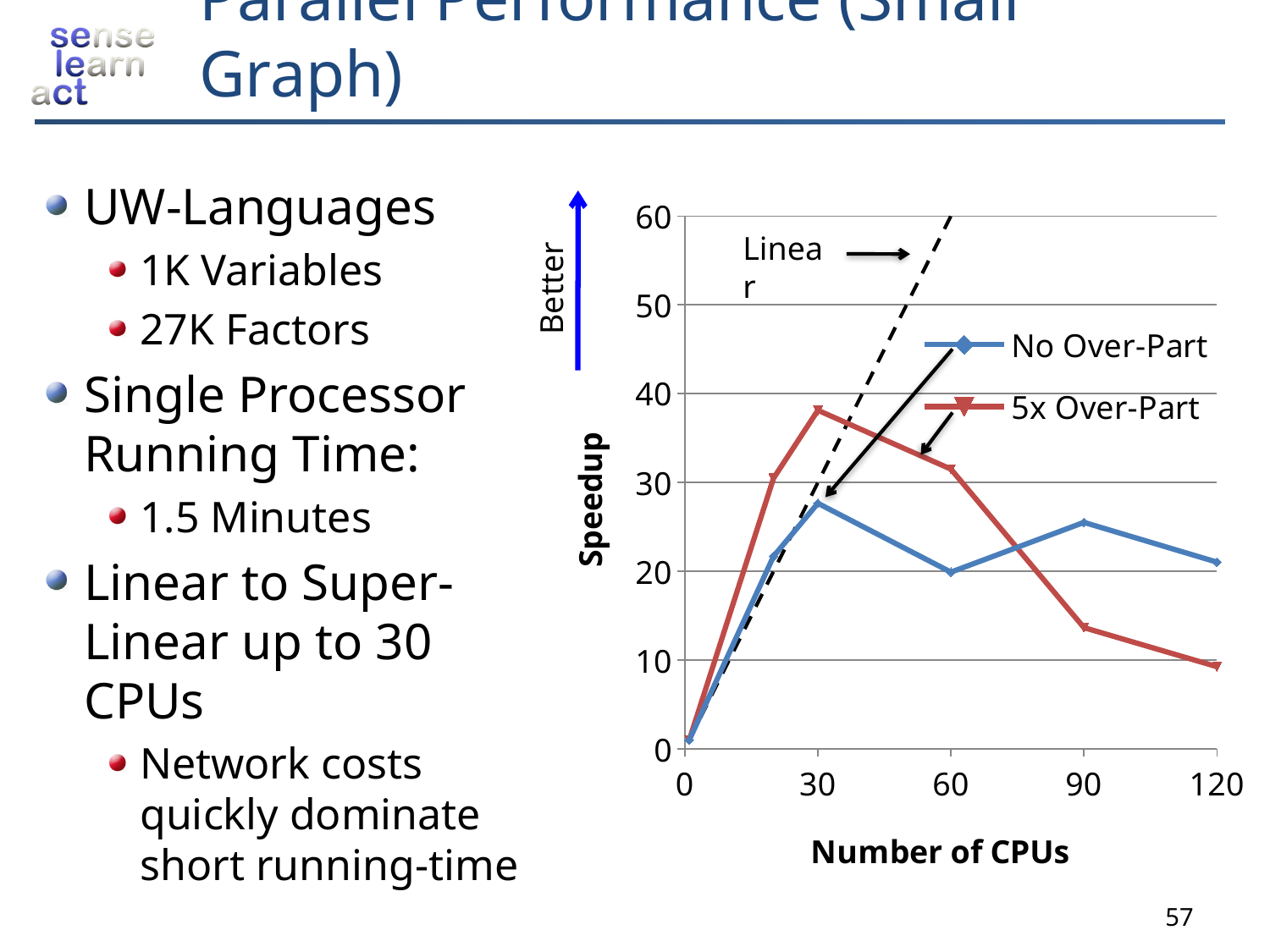
What kind of chart is shown on the slide? line chart What is the title of the chart's x axis? Number of CPUs Is the speedup for 5x Over-Part at 90 CPUs greater or less than 20? less At which number of CPUs does the 5x Over-Part series reach its highest speedup? 30 What is the title of the chart's y axis? Speedup Does the speedup for 5x Over-Part rise or fall as the number of CPUs increases from 30 to 120? fall Is the speedup for No Over-Part at 60 CPUs greater or less than 30? less At 120 CPUs, which series has the higher speedup, No Over-Part or 5x Over-Part? No Over-Part How many series does the chart legend list? 2 Is the speedup for 5x Over-Part at 30 CPUs greater or less than 30? greater At 30 CPUs, which series has the higher speedup, No Over-Part or 5x Over-Part? 5x Over-Part